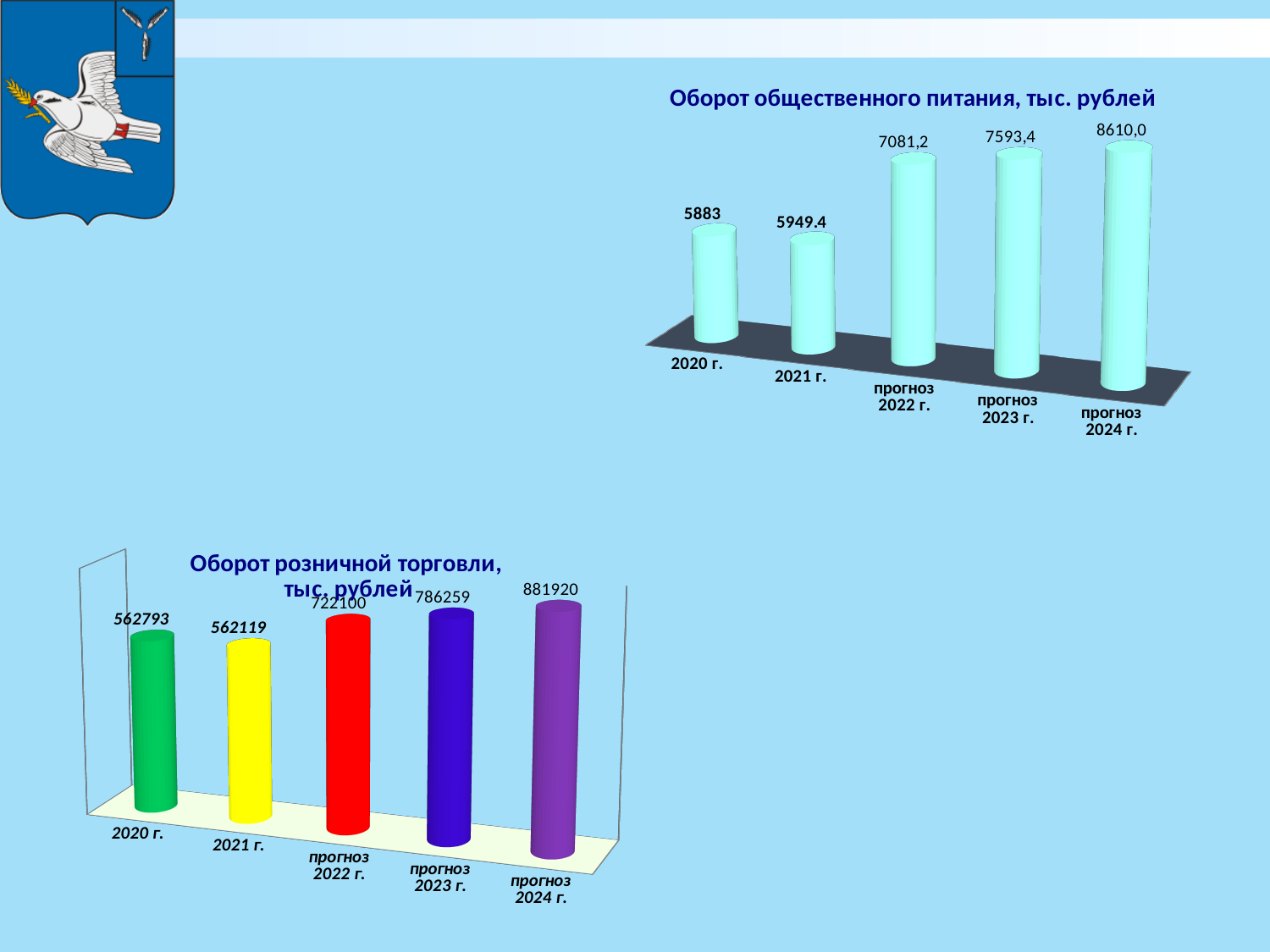
In the chart 'Оборот розничной торговли, тыс. рублей', which category has the lowest value? 2021 г. In the chart 'Оборот общественного питания, тыс. рублей', do the values rise or fall from 2020 г. to прогноз 2024 г.? rise In the chart 'Оборот общественного питания, тыс. рублей', what is the value for прогноз 2023 г.? 7593,4 In the chart 'Оборот розничной торговли, тыс. рублей', what is the difference between прогноз 2024 г. and 2020 г.? 319127 In the chart 'Оборот общественного питания, тыс. рублей', what is the difference between прогноз 2023 г. and прогноз 2022 г.? 512,2 In the chart 'Оборот общественного питания, тыс. рублей', which category has the highest value? прогноз 2024 г. In the chart 'Оборот розничной торговли, тыс. рублей', which is larger: прогноз 2023 г. or прогноз 2022 г.? прогноз 2023 г. What kind of chart is 'Оборот розничной торговли, тыс. рублей'? bar chart In the chart 'Оборот общественного питания, тыс. рублей', what is the value for 2020 г.? 5883 How many categories are shown in the chart 'Оборот общественного питания, тыс. рублей'? 5 In the chart 'Оборот розничной торговли, тыс. рублей', what is the value for 2021 г.? 562119 In the chart 'Оборот розничной торговли, тыс. рублей', what is the value for прогноз 2022 г.? 722100